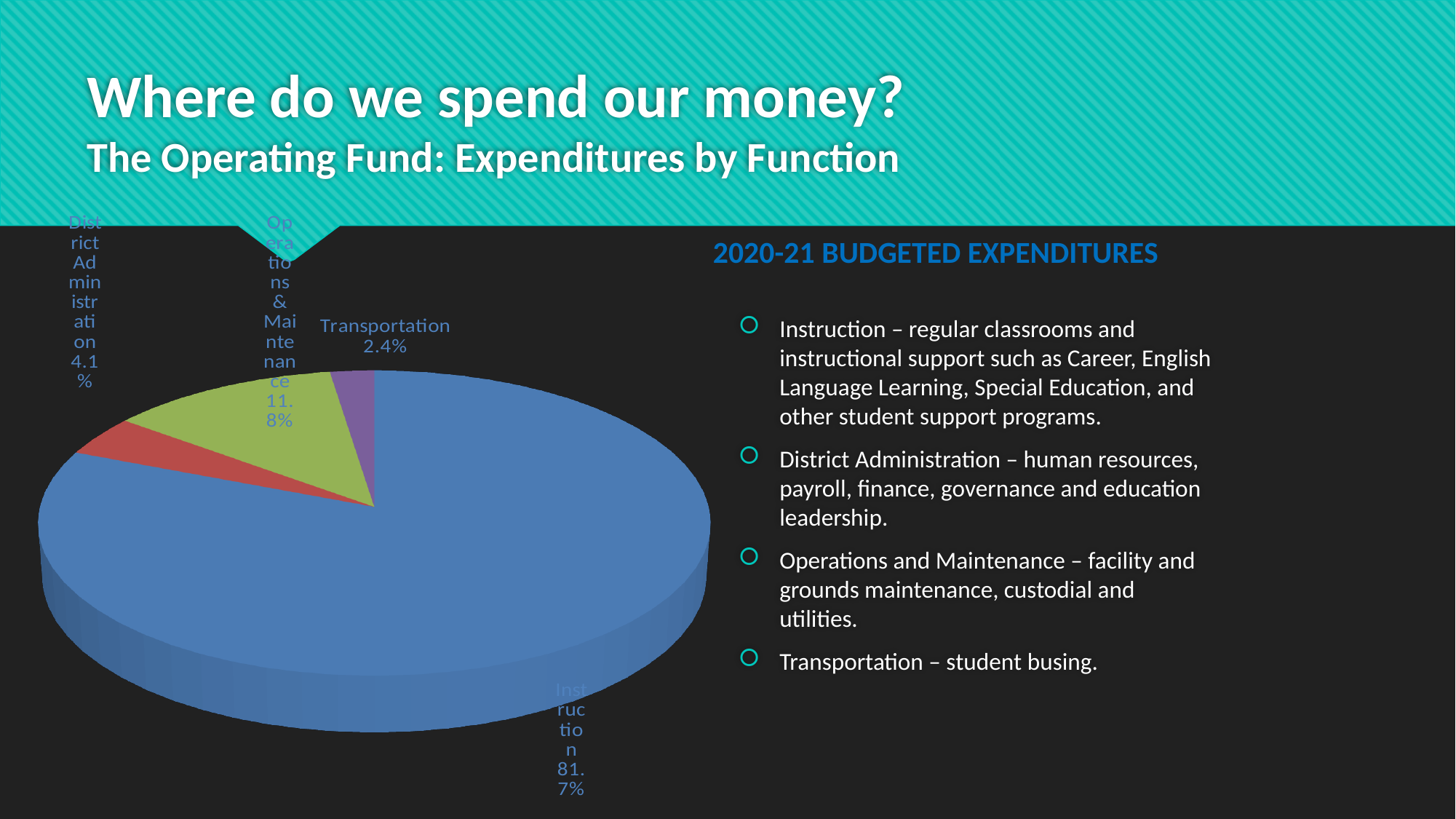
Which category has the smallest slice of the pie? Transportation Which category has the largest slice of the pie? Instruction How many slices does the pie chart have? 4 What share of the pie does Operations & Maintenance represent? 11.8% Which is larger, the share for Operations & Maintenance or the share for District Administration? Operations & Maintenance What share of the pie does Transportation represent? 2.4% What share of the pie does District Administration represent? 4.1% What is the difference in percentage points between the District Administration share and the Transportation share? 1.7 What is the difference in percentage points between the Instruction share and the Operations & Maintenance share? 69.9 What colour is the Instruction slice of the pie? blue What kind of chart is shown on the slide? pie chart